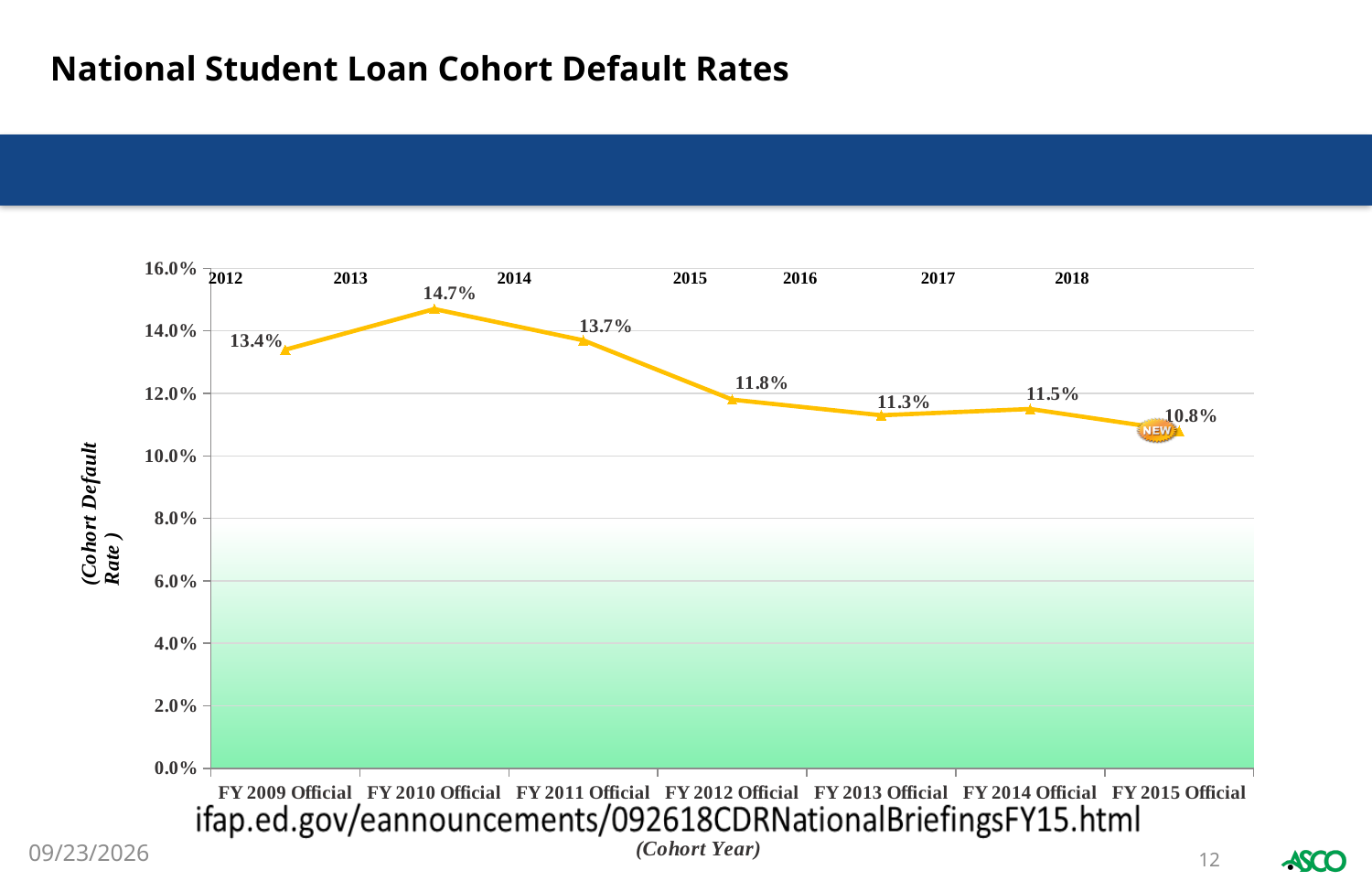
Is the value for FY 2011 Official greater or less than 12.0%? greater What is the cohort default rate for FY 2012 Official? 11.8% How many cohort years are plotted on the chart? 7 What is the label on the vertical axis of the chart? (Cohort Default Rate ) What is the cohort default rate for FY 2010 Official? 14.7% What is the cohort default rate for FY 2015 Official? 10.8% Which cohort year has the lowest default rate? FY 2015 Official What is the difference between the default rates for FY 2010 Official and FY 2015 Official? 3.9% Which cohort year has the highest default rate? FY 2010 Official What kind of chart is shown on the slide? line chart Which is larger, the default rate for FY 2013 Official or FY 2014 Official? FY 2014 Official Do the default rates generally rise or fall from FY 2010 Official to FY 2015 Official? fall